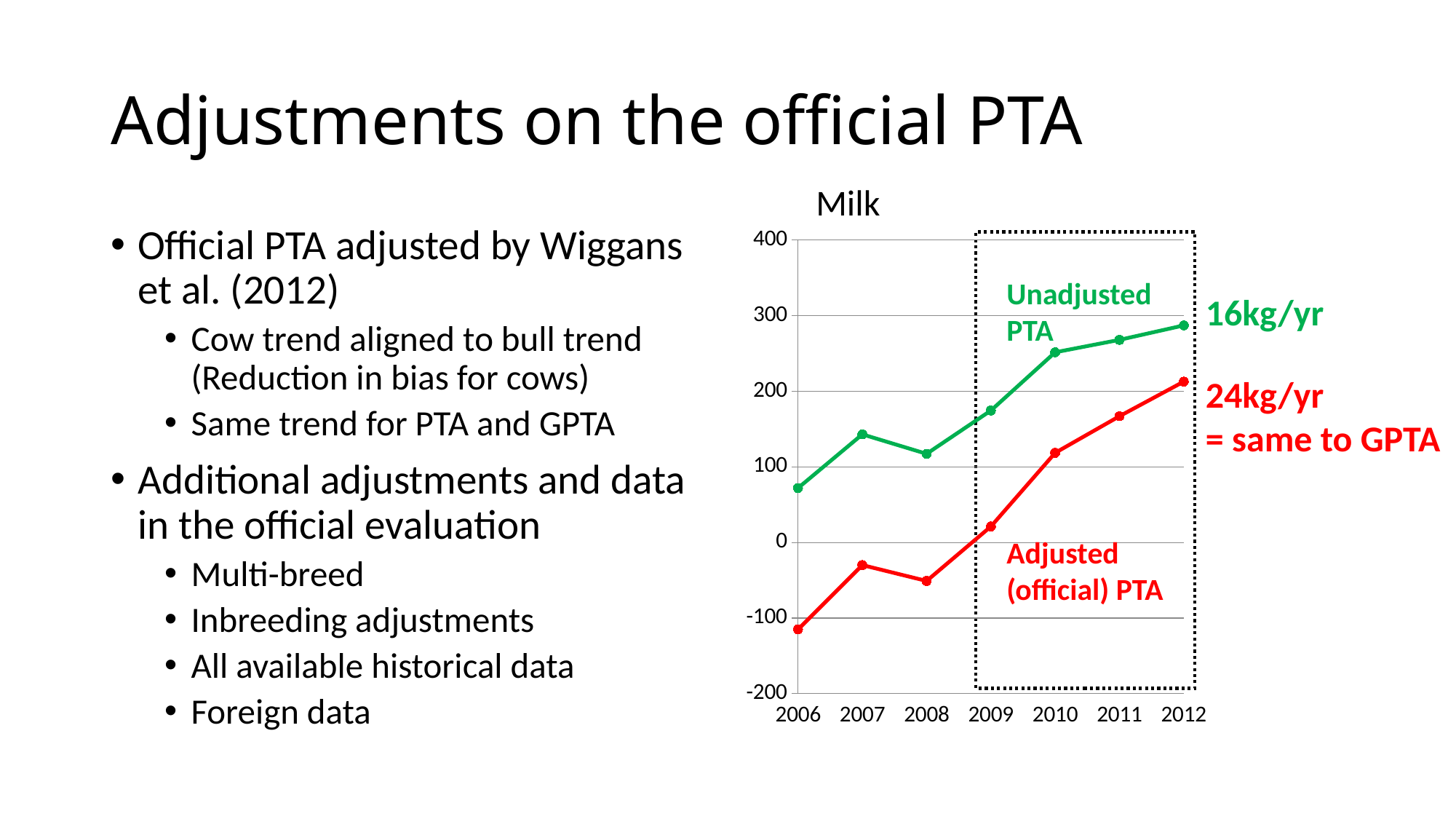
What annual trend is annotated next to the Adjusted (official) PTA line? 24kg/yr In 2009, which series has the larger value, Unadjusted PTA or Adjusted (official) PTA? Unadjusted PTA How many years are plotted along the x axis of the chart? 7 What is the title of the chart? Milk Is the Unadjusted PTA value for 2006 greater or less than 100? less Is the Unadjusted PTA value for 2010 greater or less than 200? greater What kind of chart is shown on the slide? line chart Does the Adjusted (official) PTA line rise or fall from 2009 to 2012? rise How many series are plotted in the chart? 2 Is the Adjusted (official) PTA value for 2006 greater or less than -100? less In which year is the Adjusted (official) PTA value lowest? 2006 In which year is the Unadjusted PTA value highest? 2012